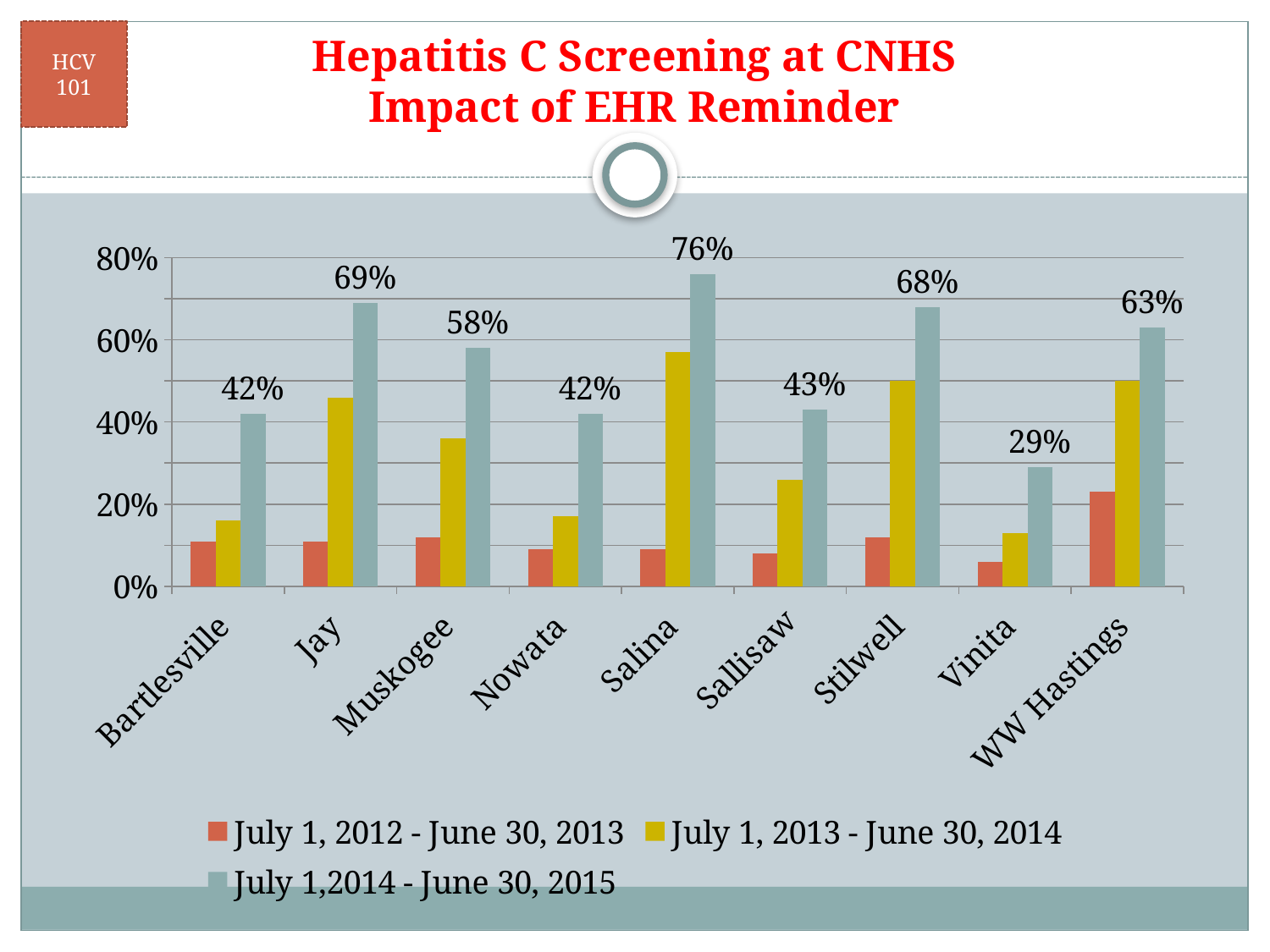
How many series does the legend list? 3 How many clinic sites are shown on the x axis? 9 Is the value for Jay in the July 1, 2013 - June 30, 2014 series greater or less than 40%? greater What is the value for Muskogee in the July 1, 2014 - June 30, 2015 series? 58% For Salina, do the values rise or fall from the 2012-2013 period to the 2014-2015 period? rise What is the value for Salina in the July 1, 2014 - June 30, 2015 series? 76% What is the difference between Jay and Stilwell in the July 1, 2014 - June 30, 2015 series? 1% What is the value for Vinita in the July 1, 2014 - June 30, 2015 series? 29% What kind of chart is shown on the slide? bar chart In the July 1, 2014 - June 30, 2015 series, which is larger, WW Hastings or Sallisaw? WW Hastings Which site has the highest value in the July 1, 2014 - June 30, 2015 series? Salina Which site has the lowest value in the July 1, 2014 - June 30, 2015 series? Vinita